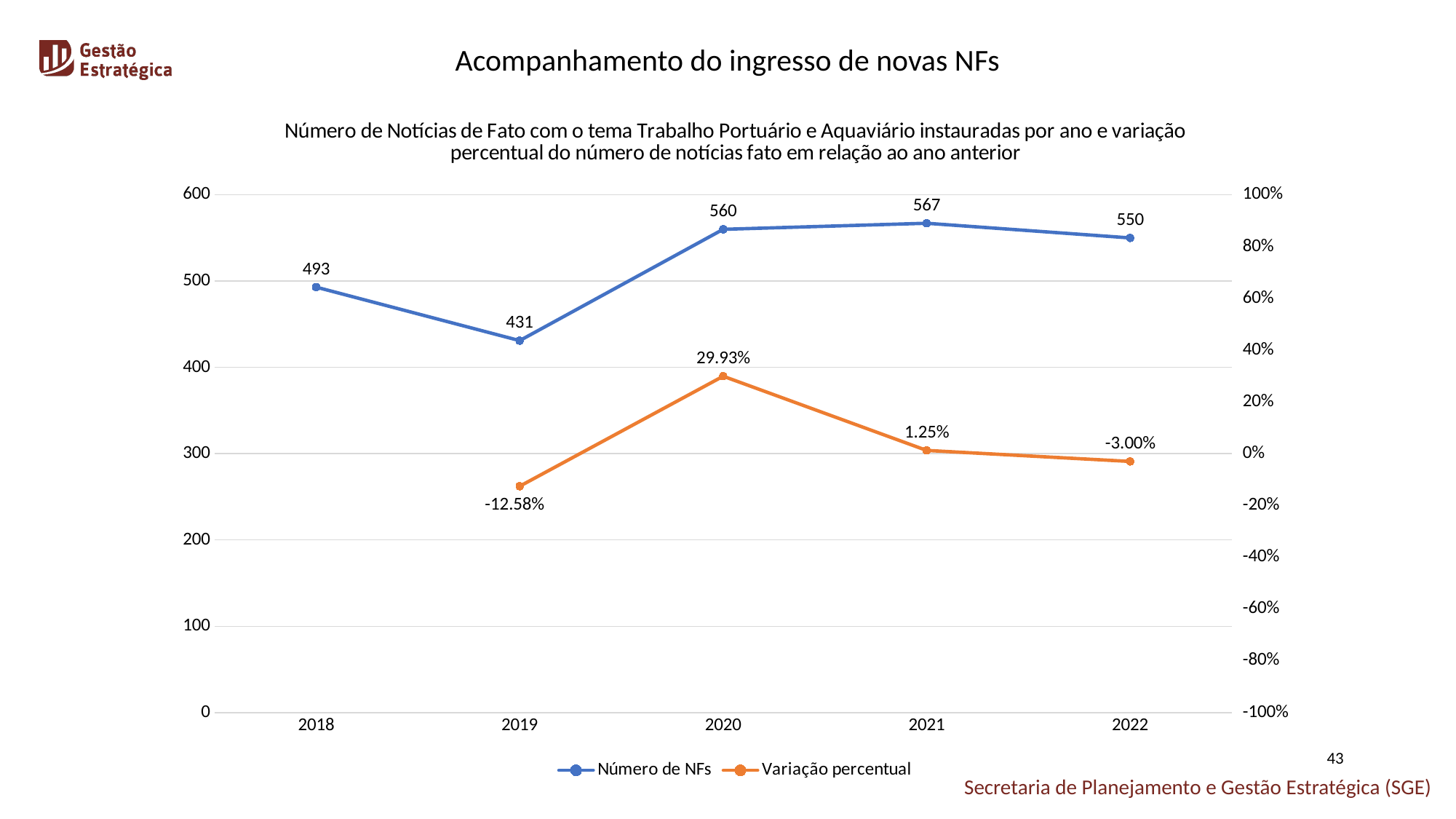
What kind of chart is shown on the slide? line chart Which year has the highest Variação percentual? 2020 Which year has the lowest Número de NFs? 2019 What is the difference between the Número de NFs in 2021 and in 2019? 136 Does the Número de NFs rise or fall from 2019 to 2020? rise What is the Variação percentual for 2019? -12.58% What colour is the line for Variação percentual? orange Which year has the highest Número de NFs? 2021 What is the value of Número de NFs for 2020? 560 Which is larger, the Número de NFs in 2018 or in 2022? 2022 How many series does the legend list? 2 How many years are shown on the x axis? 5